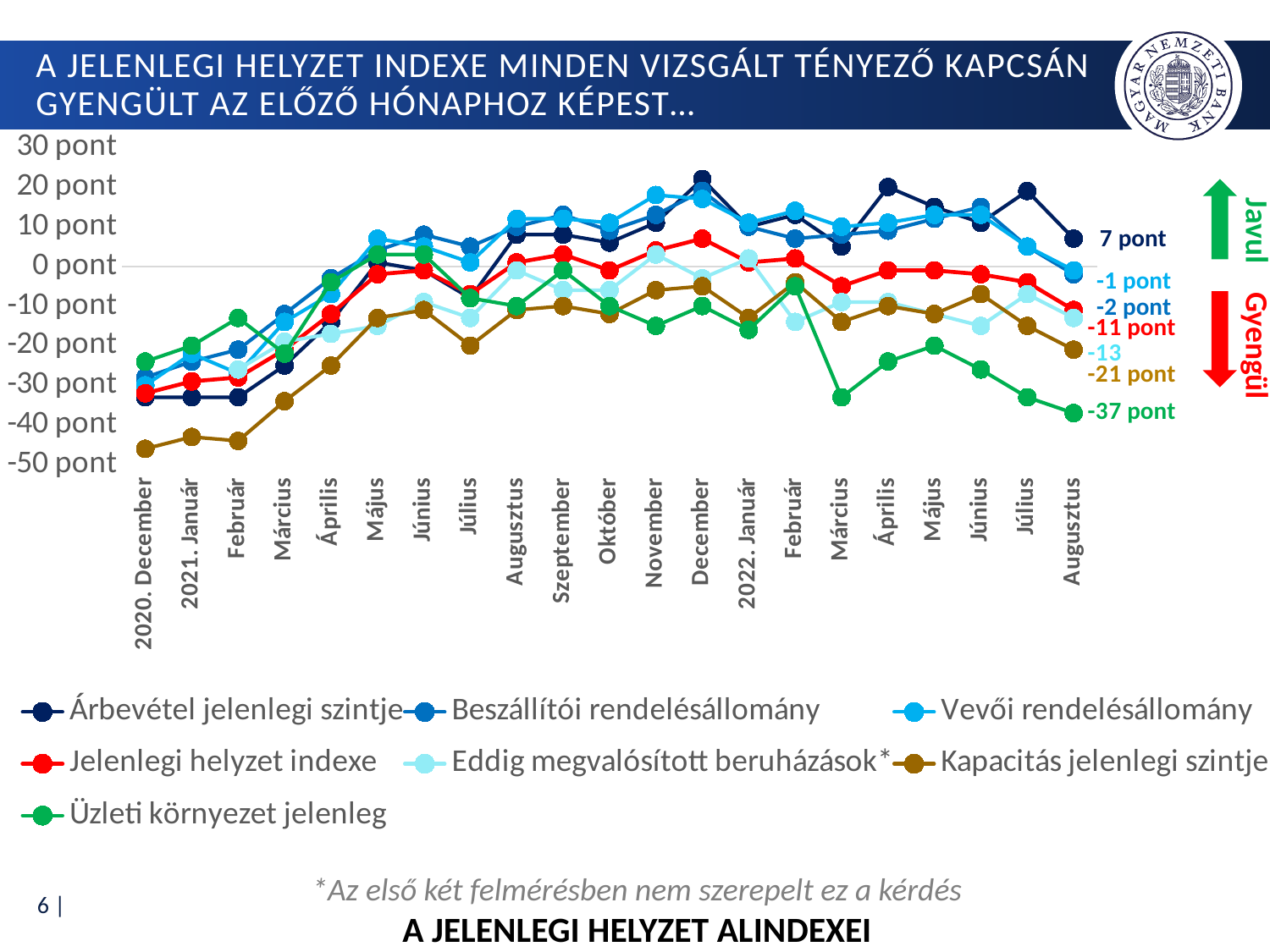
Which series has the lowest value in 2022 Augusztus? Üzleti környezet jelenleg How many series does the legend list? 7 How many months are shown along the x axis? 21 What is the value of Kapacitás jelenlegi szintje in 2022 Augusztus? -21 pont Is the value of Kapacitás jelenlegi szintje in 2020 December greater or less than -40 pont? less What is the value of Jelenlegi helyzet indexe in 2022 Augusztus? -11 pont What is the value of Árbevétel jelenlegi szintje in 2022 Augusztus? 7 pont What is the difference between Árbevétel jelenlegi szintje and Üzleti környezet jelenleg in 2022 Augusztus? 44 pont What kind of chart is shown on the slide? line chart Which series has the highest value in 2022 Augusztus? Árbevétel jelenlegi szintje What is the value of Üzleti környezet jelenleg in 2022 Augusztus? -37 pont Does Üzleti környezet jelenleg rise or fall from 2022 Február to 2022 Augusztus? fall